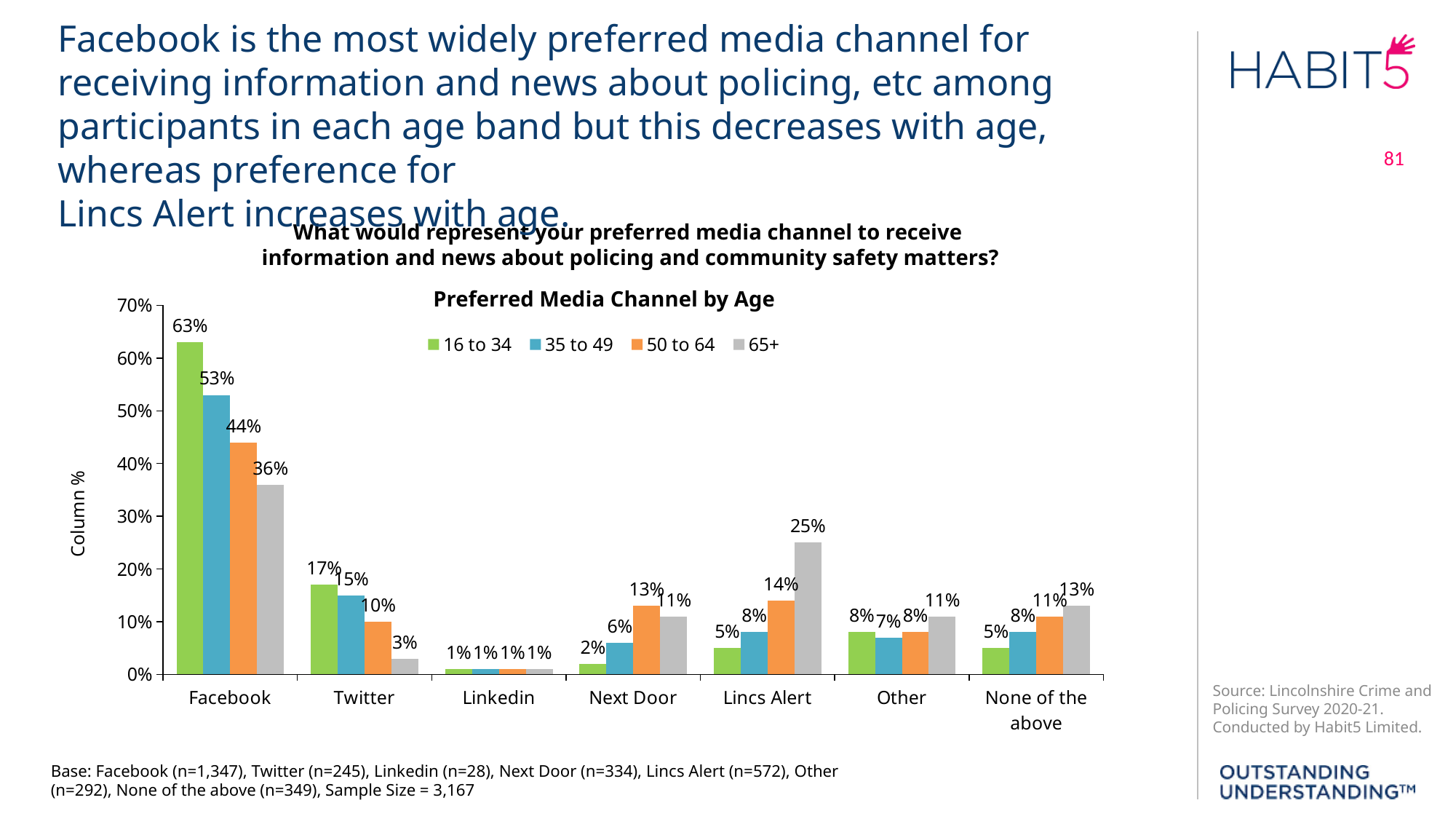
How many media channel categories are shown on the x axis? 7 What is the value for the 65+ age group for Lincs Alert? 25% Which media channel has the lowest value for the 65+ age group? Linkedin What is the difference between the 16 to 34 and 65+ values for Facebook? 27% For Next Door, which age group has the larger value: 35 to 49 or 50 to 64? 50 to 64 What is the value for the 50 to 64 age group for Twitter? 10% What percentage of 16 to 34 year olds prefer Facebook? 63% How many age groups does the legend list? 4 For Lincs Alert, do the values rise or fall as the age band increases from 16 to 34 to 65+? Rise What is the title of the chart? Preferred Media Channel by Age What kind of chart is shown on the slide? Bar chart Which media channel has the highest value for the 35 to 49 age group? Facebook